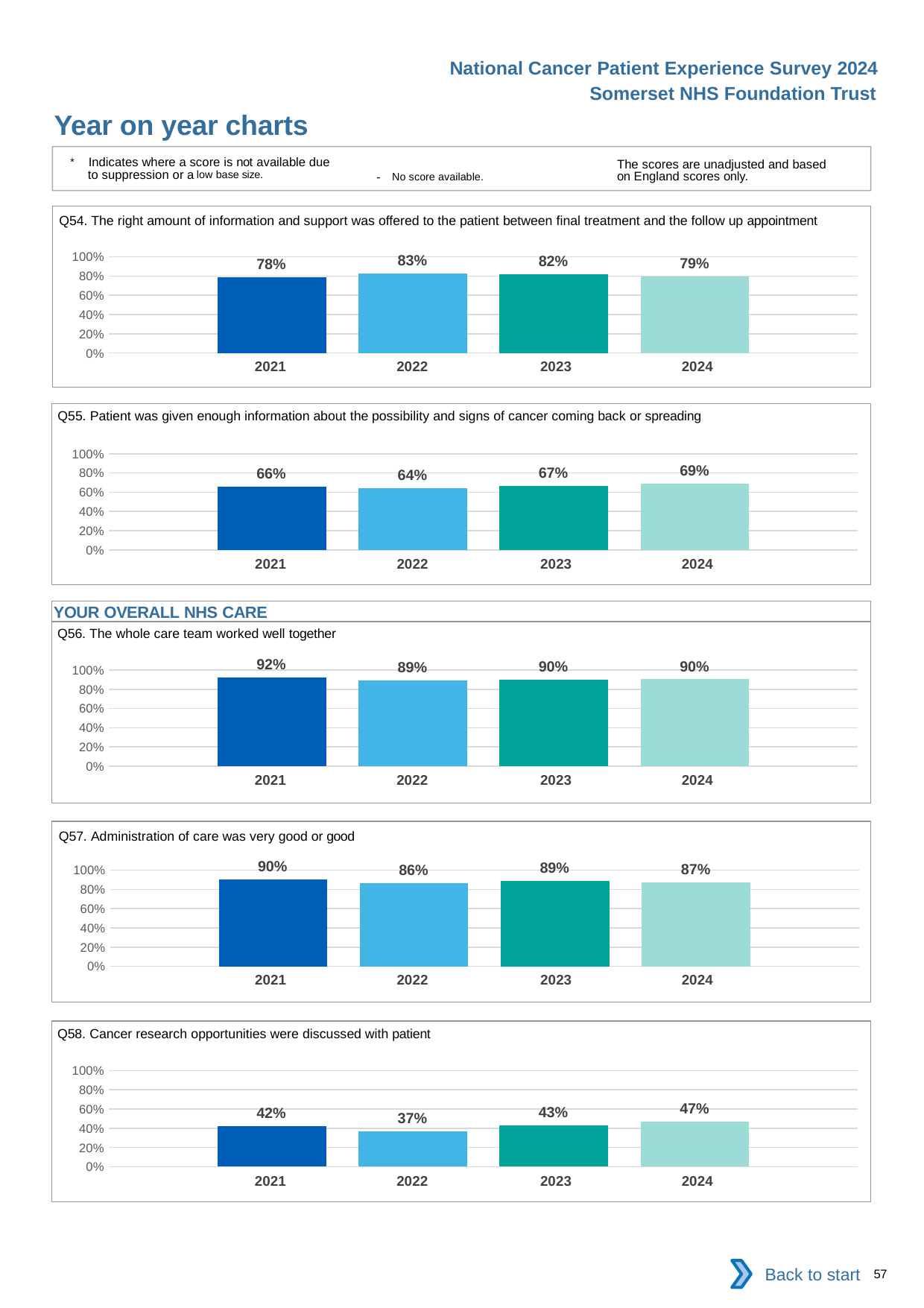
In the Q58 chart, what is the value for 2022? 37% In the Q55 chart, what is the difference between the 2024 and 2022 values? 5 percentage points In the Q57 chart, which is larger, the value for 2022 or the value for 2024? 2024 In the Q56 chart, which year has the highest value? 2021 In the Q55 chart, which year has the highest value? 2024 In the Q58 chart, what is the difference between the 2024 and 2021 values? 5 percentage points In the Q54 chart, which year has the lowest value? 2021 How many years are shown on the x axis of the Q58 chart? 4 In the Q55 chart, what is the value for 2024? 69% In the Q56 chart, what is the value for 2021? 92% In the Q54 chart, what is the value for 2022? 83% In the Q57 chart, what is the value for 2023? 89%